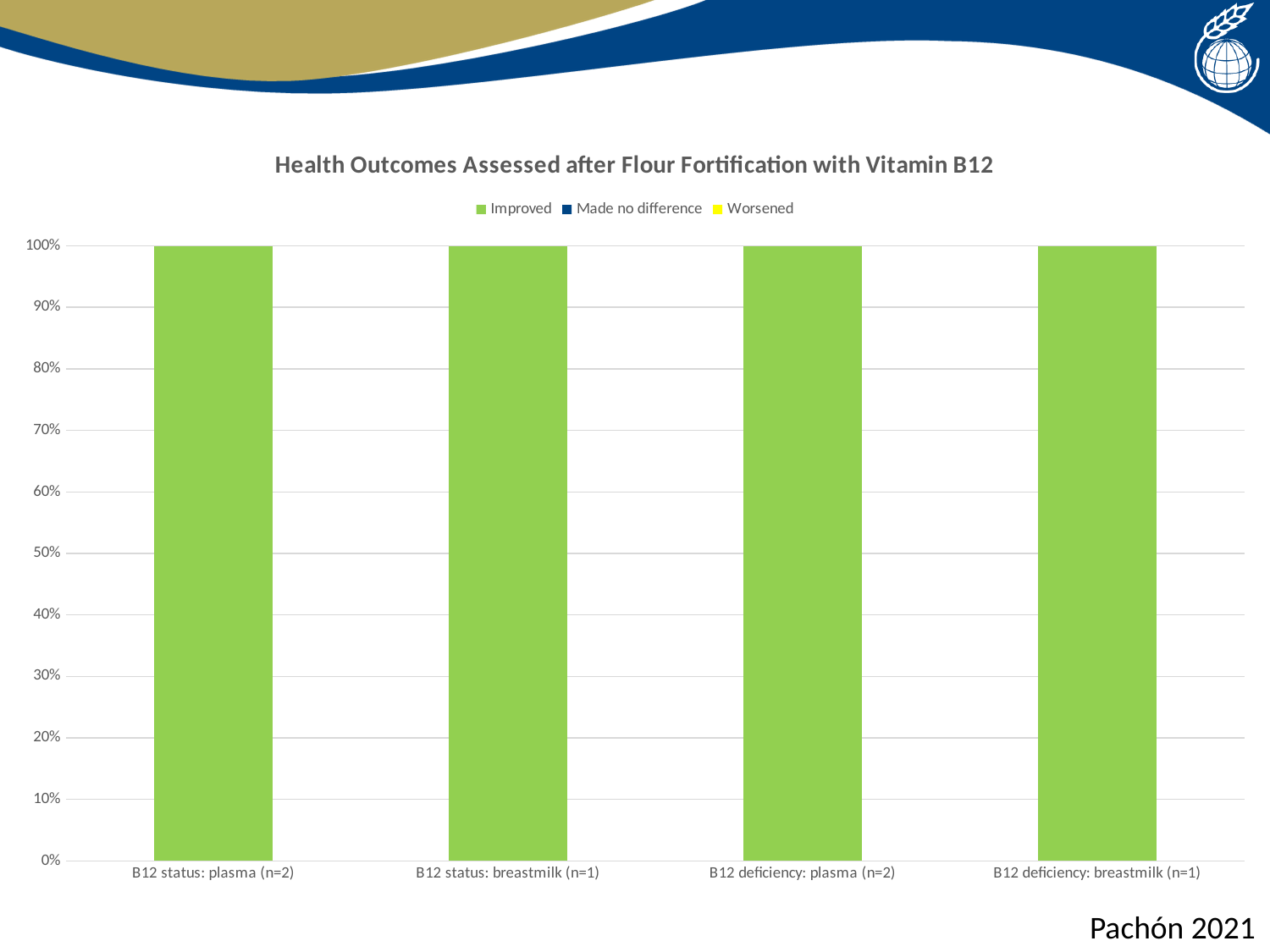
Which legend entry is shown in green? Improved What is the title of the chart? Health Outcomes Assessed after Flour Fortification with Vitamin B12 What is the value for Improved in the B12 status: plasma (n=2) category? 100% Do the Improved values rise, fall, or stay the same across the categories from left to right? stay the same What is the value for Improved in the B12 deficiency: breastmilk (n=1) category? 100% What kind of chart is shown on the slide? bar chart How many categories are shown on the x axis? 4 How many series does the legend list? 3 What is the value for Improved in the B12 status: breastmilk (n=1) category? 100% Is the value for Improved in the B12 deficiency: plasma (n=2) category greater or less than 50%? greater Which series accounts for the entire bar in every category? Improved What is the difference between the Improved values for B12 status: plasma (n=2) and B12 deficiency: plasma (n=2)? 0%